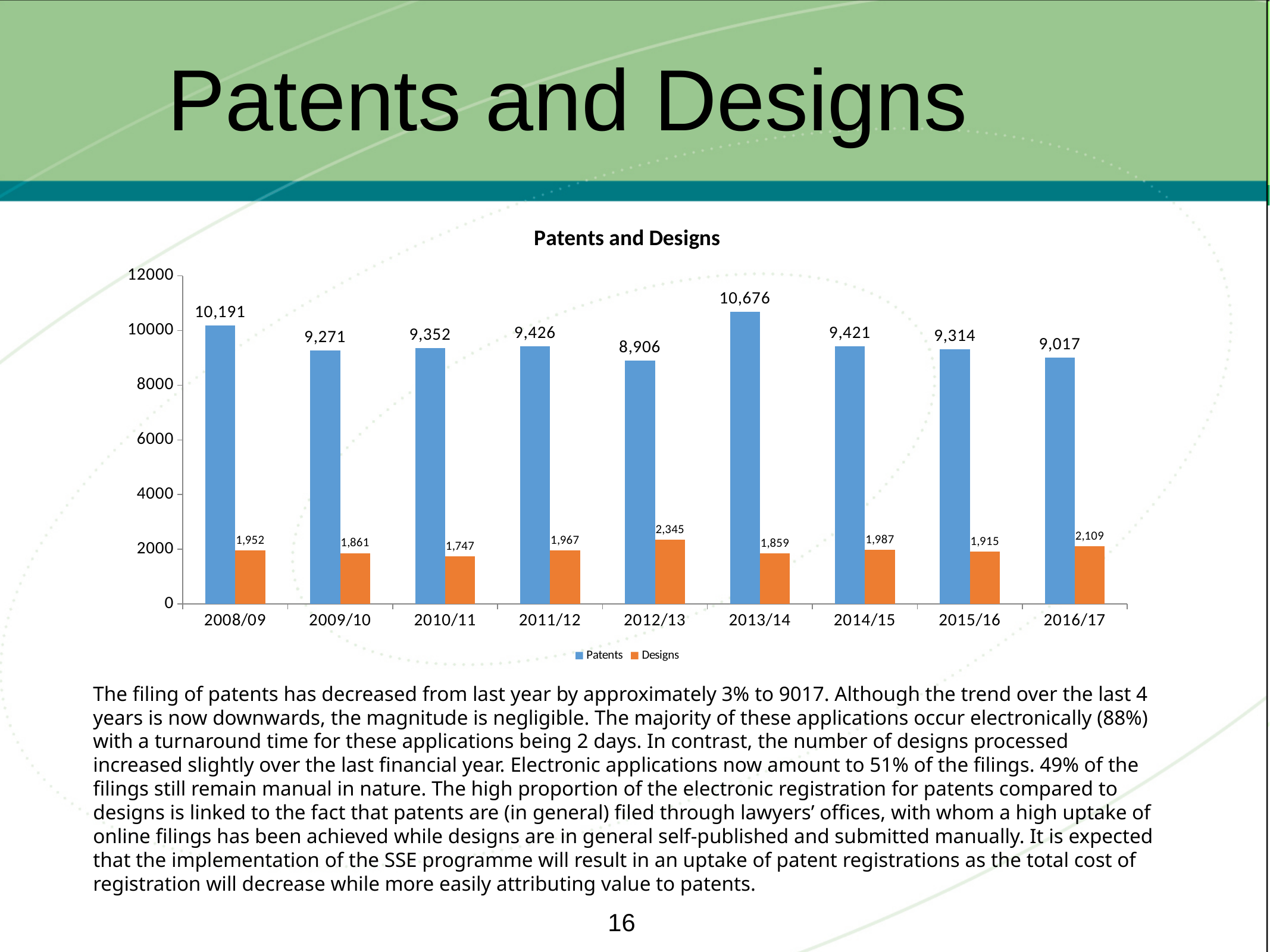
Which year has the lowest value for Designs? 2010/11 What kind of chart is shown on the slide? Bar chart What is the title of the chart? Patents and Designs How many years are shown on the x axis? 9 What is the value for Designs in 2012/13? 2,345 What is the difference between the Patents value in 2013/14 and the Patents value in 2012/13? 1,770 Which year has the lowest value for Patents? 2012/13 What is the value for Patents in 2013/14? 10,676 How many series does the legend list? 2 Which is larger, the Designs value in 2016/17 or the Designs value in 2008/09? 2016/17 What is the value for Patents in 2016/17? 9,017 Which year has the highest value for Patents? 2013/14